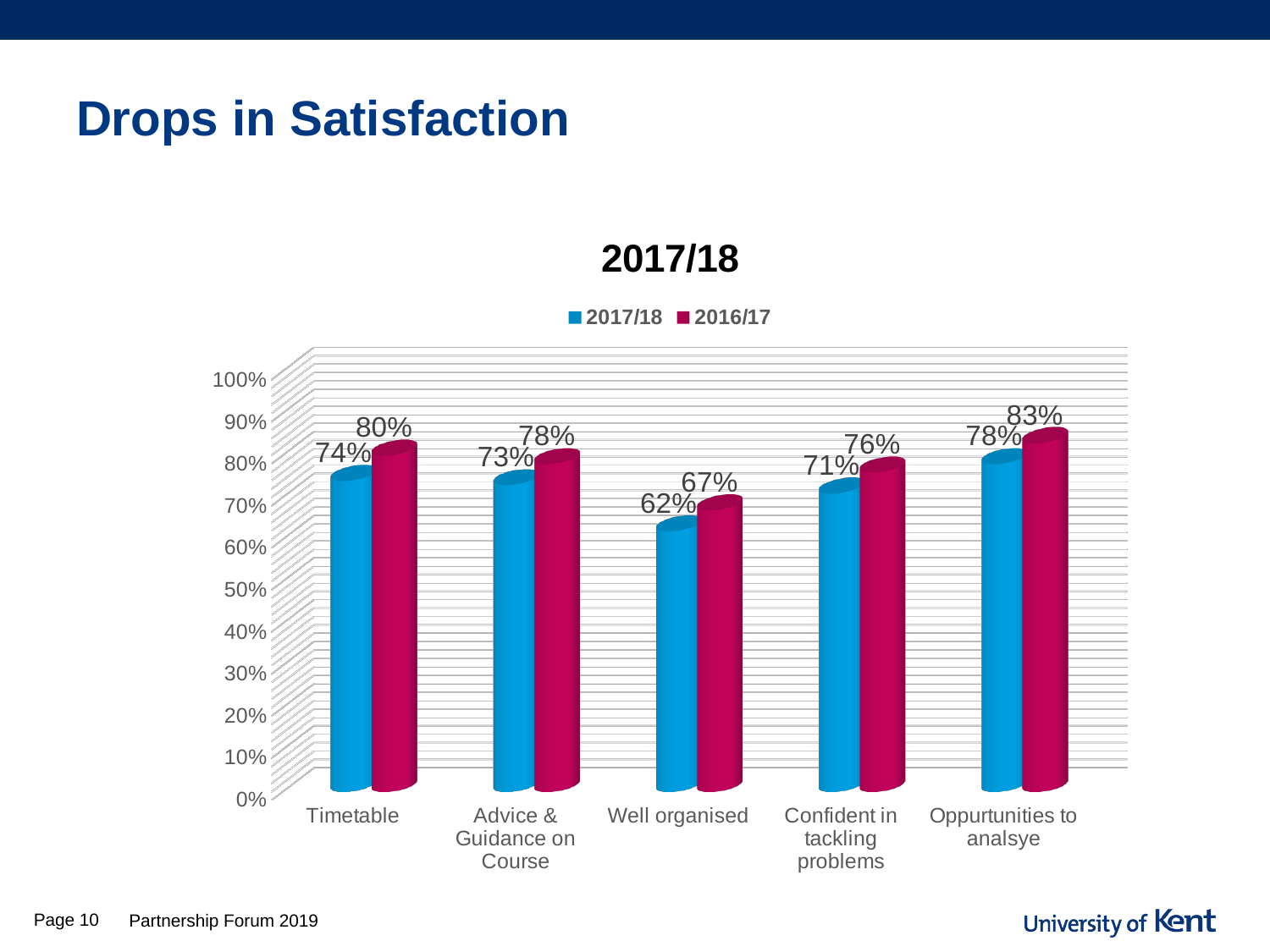
How many categories are shown on the x axis? 5 What is the 2016/17 value for Well organised? 67% What is the difference between the 2016/17 and 2017/18 values for Timetable? 6% Which category has the highest 2016/17 value? Oppurtunities to analsye What kind of chart is shown on the slide? Bar chart Which category has the lowest 2017/18 value? Well organised What is the 2016/17 value for Oppurtunities to analsye? 83% How many series does the legend list? 2 Which is larger for Confident in tackling problems: the 2017/18 value or the 2016/17 value? 2016/17 What is the 2017/18 value for Confident in tackling problems? 71% What is the difference between the 2016/17 and 2017/18 values for Advice & Guidance on Course? 5% What is the 2017/18 value for Timetable? 74%